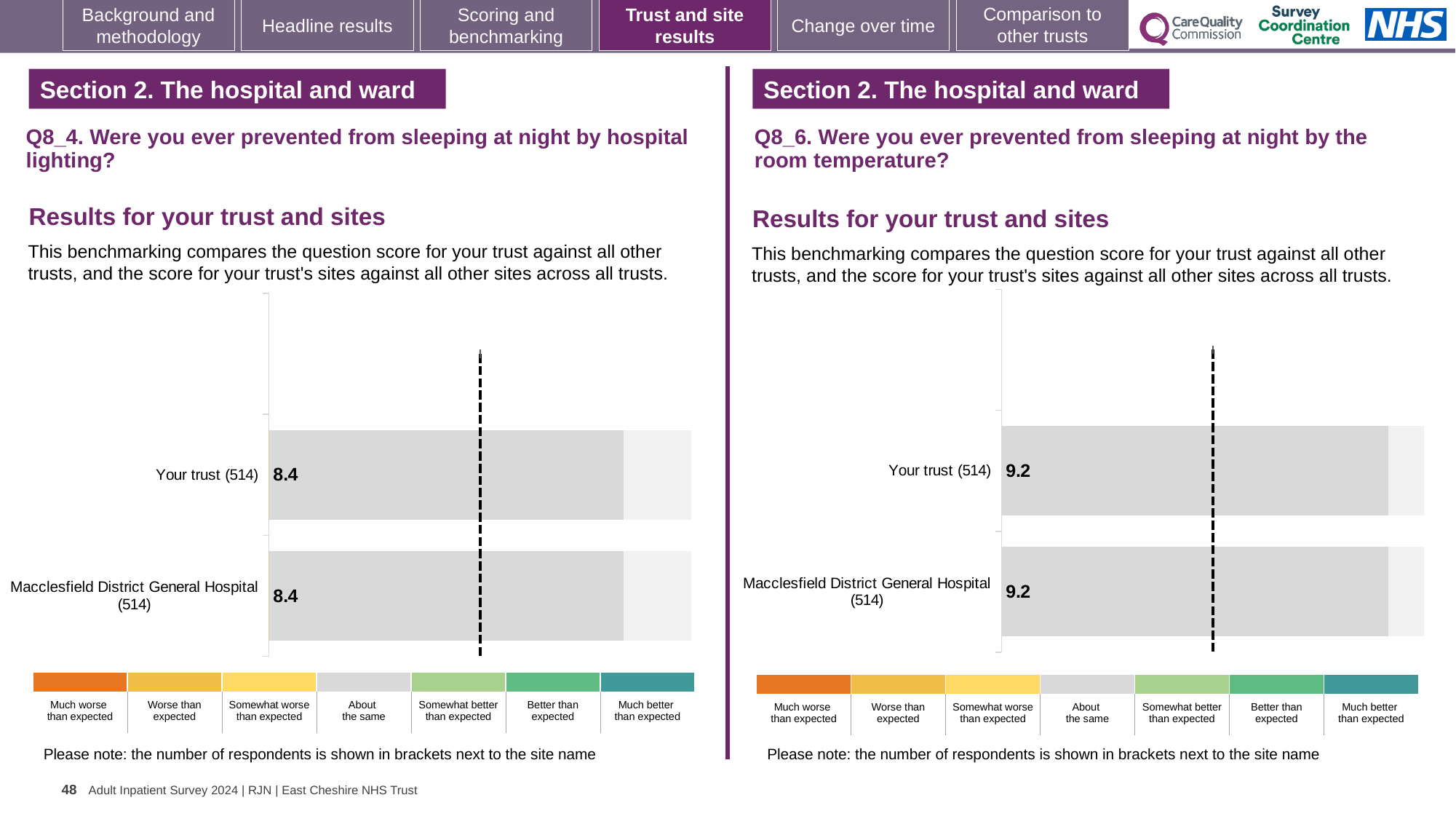
In the Q8_6 room temperature chart, what is the difference between the score for Your trust and the score for Macclesfield District General Hospital? 0 In the Q8_4 hospital lighting chart, what is the score for Macclesfield District General Hospital (514)? 8.4 How many benchmark categories does the colour legend below the Q8_4 hospital lighting chart list? 7 In the Q8_6 room temperature chart, what is the score for Your trust (514)? 9.2 In the Q8_4 hospital lighting chart, how many respondents are shown in brackets for Your trust? 514 In the legend below the Q8_6 room temperature chart, which category is shown in orange? Much worse than expected What kind of chart is used for the Q8_6 room temperature results? Bar chart How many bars are plotted in the Q8_4 hospital lighting chart? 2 How many bars are plotted in the Q8_6 room temperature chart? 2 In the Q8_6 room temperature chart, what is the score for Macclesfield District General Hospital (514)? 9.2 In the Q8_4 hospital lighting chart, what is the score for Your trust (514)? 8.4 In the Q8_4 hospital lighting chart, what is the difference between the score for Your trust and the score for Macclesfield District General Hospital? 0